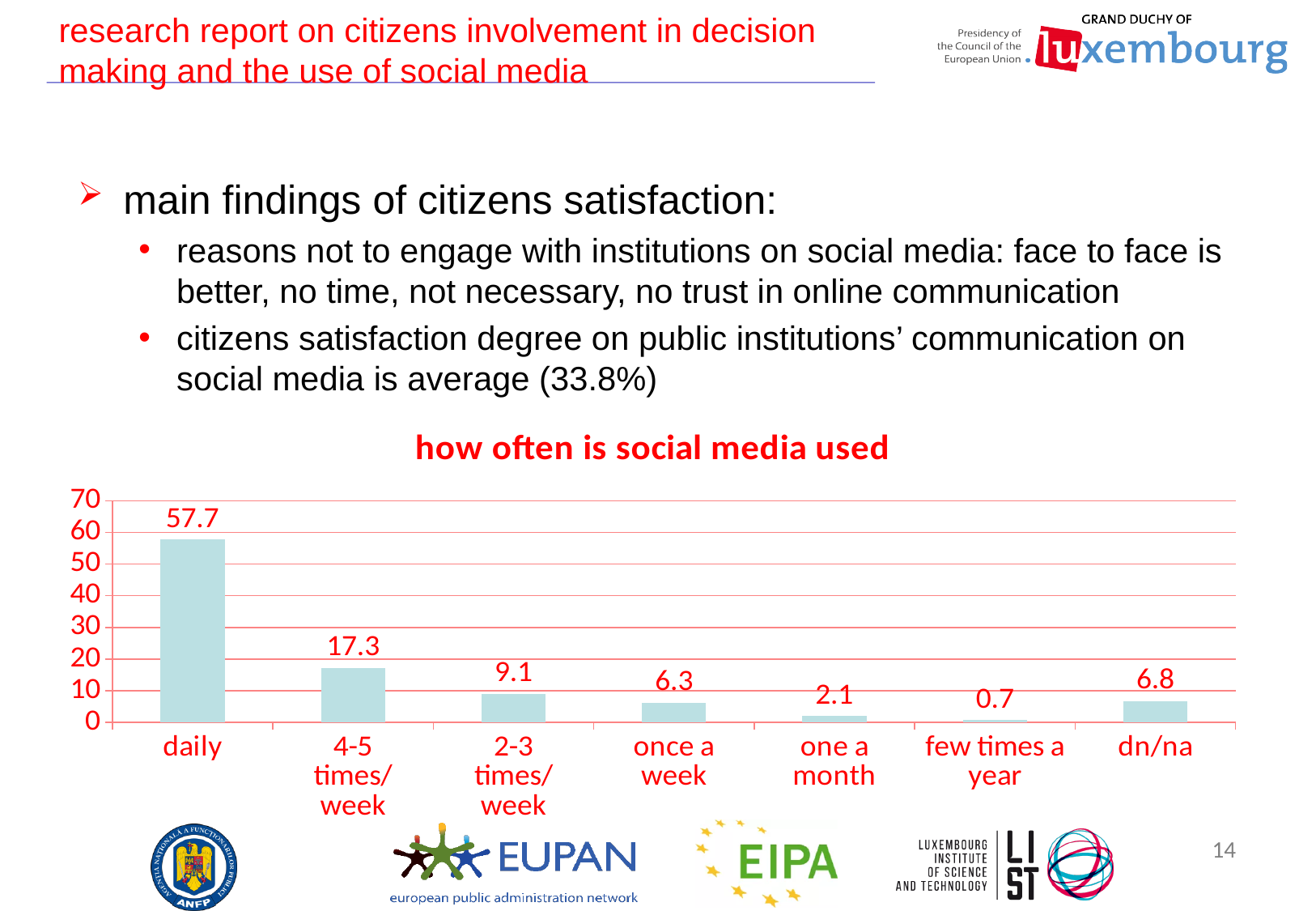
How many categories are shown on the x axis of the chart? 7 What is the value for '4-5 times/week' in the chart? 17.3 Which category has the highest value in the chart? daily What is the value for 'daily' in the chart? 57.7 What is the value for 'few times a year' in the chart? 0.7 Is the value for '2-3 times/week' greater or less than 10? less What is the title of the chart? how often is social media used Which is larger, the value for 'once a week' or the value for 'dn/na'? dn/na Which category has the lowest value in the chart? few times a year What is the difference between the values for 'daily' and '4-5 times/week'? 40.4 What is the value for 'dn/na' in the chart? 6.8 What kind of chart is shown on the slide? bar chart